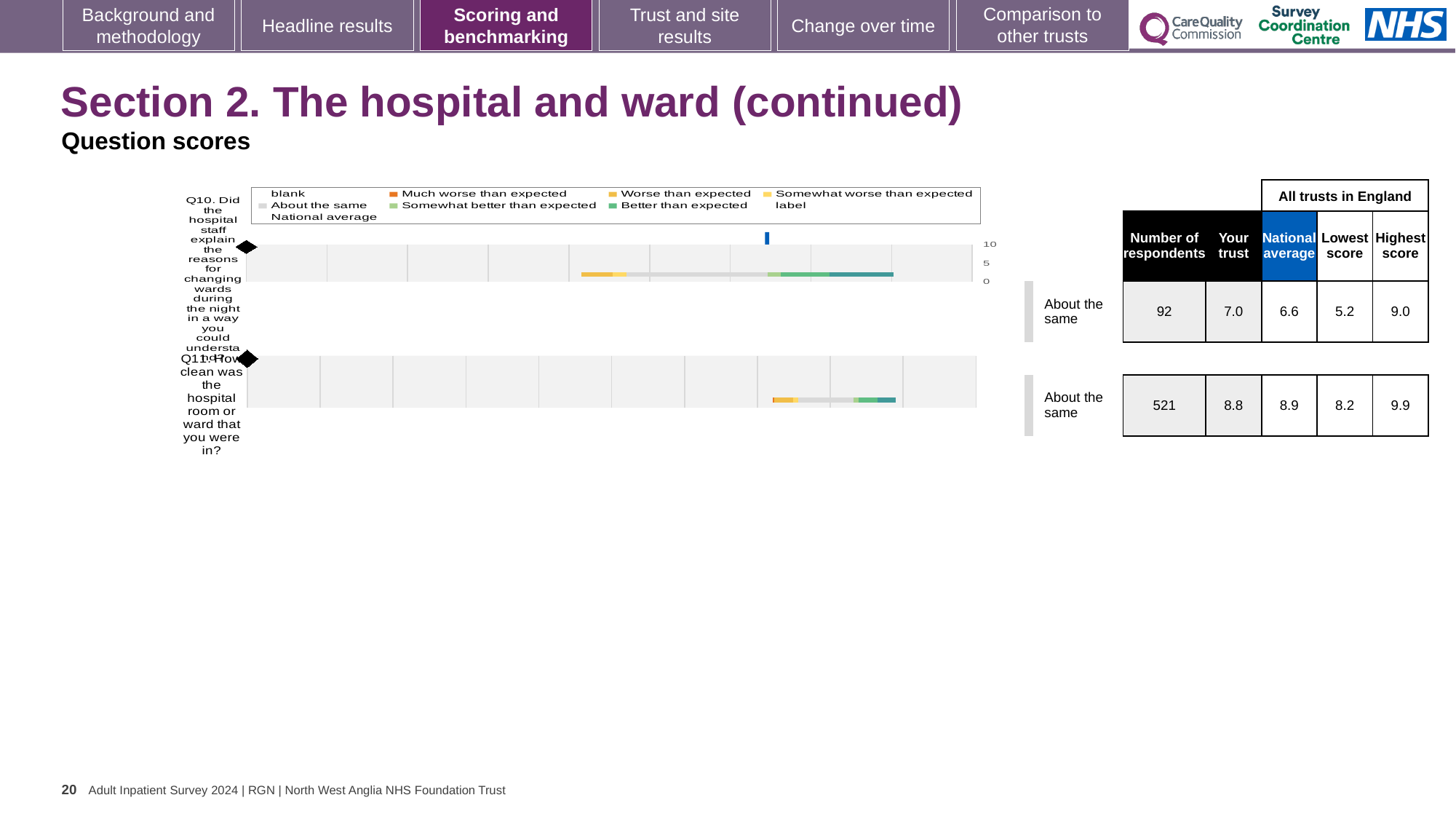
What is the number of respondents for Q10 (explaining reasons for changing wards during the night)? 92 What kind of chart is used to show the question scores for Q10 and Q11? Bar chart What is the difference between the highest score and the lowest score for Q11? 1.7 How many questions are plotted in the chart? 2 What is the 'Your trust' score for Q11 (how clean was the hospital room or ward)? 8.8 What benchmark category is shown next to the Q10 bar? About the same What is the lowest score among all trusts in England for Q11? 8.2 What heading appears above the 'Lowest score' and 'Highest score' columns in the table? All trusts in England Which question has more respondents, Q10 or Q11? Q11 What is the national average score for Q10? 6.6 How many more respondents answered Q11 than Q10? 429 For Q10, which is higher: the 'Your trust' score or the national average? Your trust